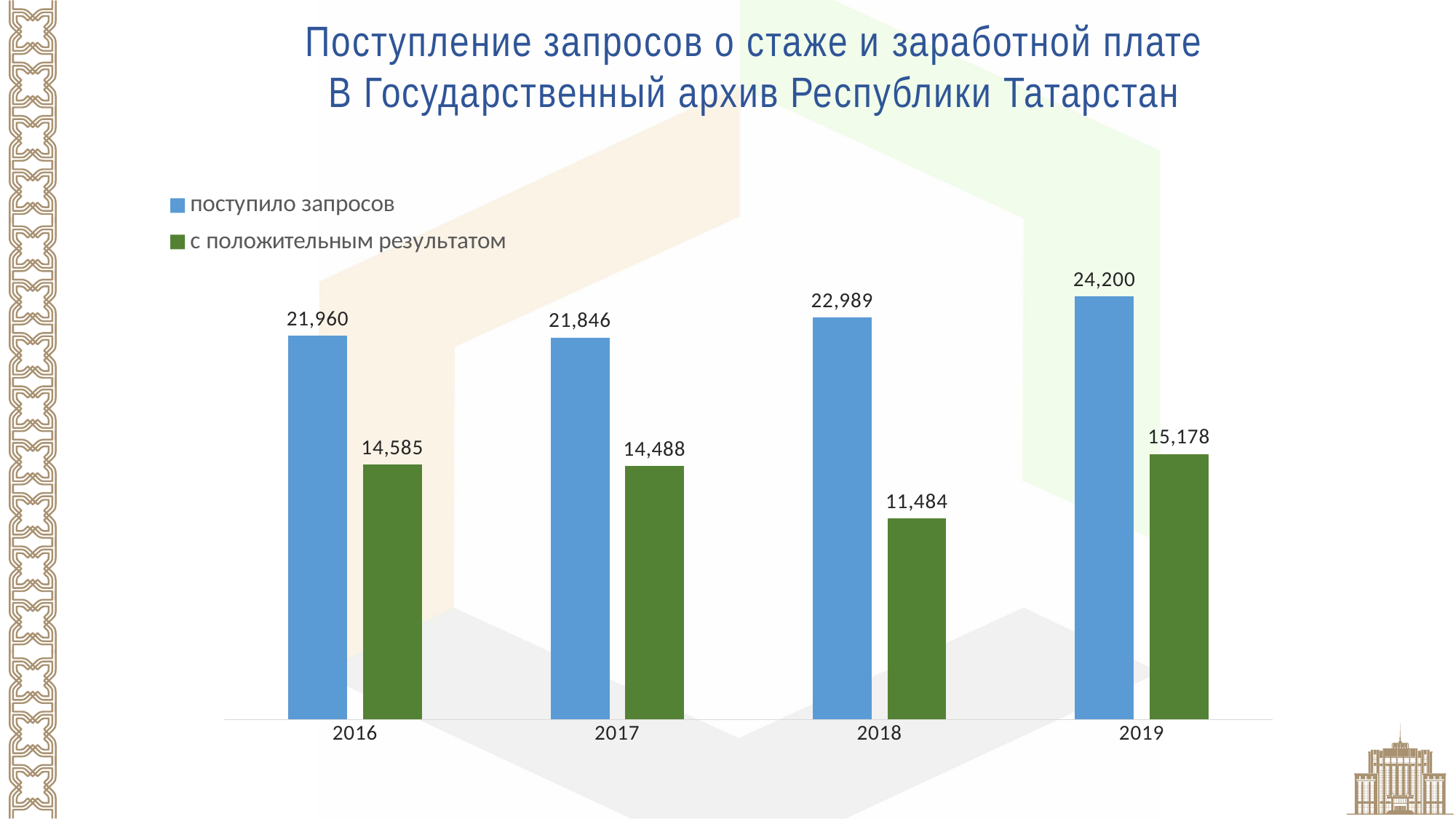
What kind of chart is shown on the slide? Bar chart What was the value for "поступило запросов" in 2019? 24,200 Does "поступило запросов" rise or fall from 2017 to 2019? Rise Which is larger: "с положительным результатом" in 2016 or in 2019? 2019 What was the value for "поступило запросов" in 2016? 21,960 How many years are shown on the x axis? 4 In which year was "поступило запросов" highest? 2019 Which colour represents "с положительным результатом" in the legend? Green In which year was "с положительным результатом" lowest? 2018 What was the value for "с положительным результатом" in 2018? 11,484 What is the difference between "поступило запросов" and "с положительным результатом" in 2017? 7,358 How many series does the legend list? 2